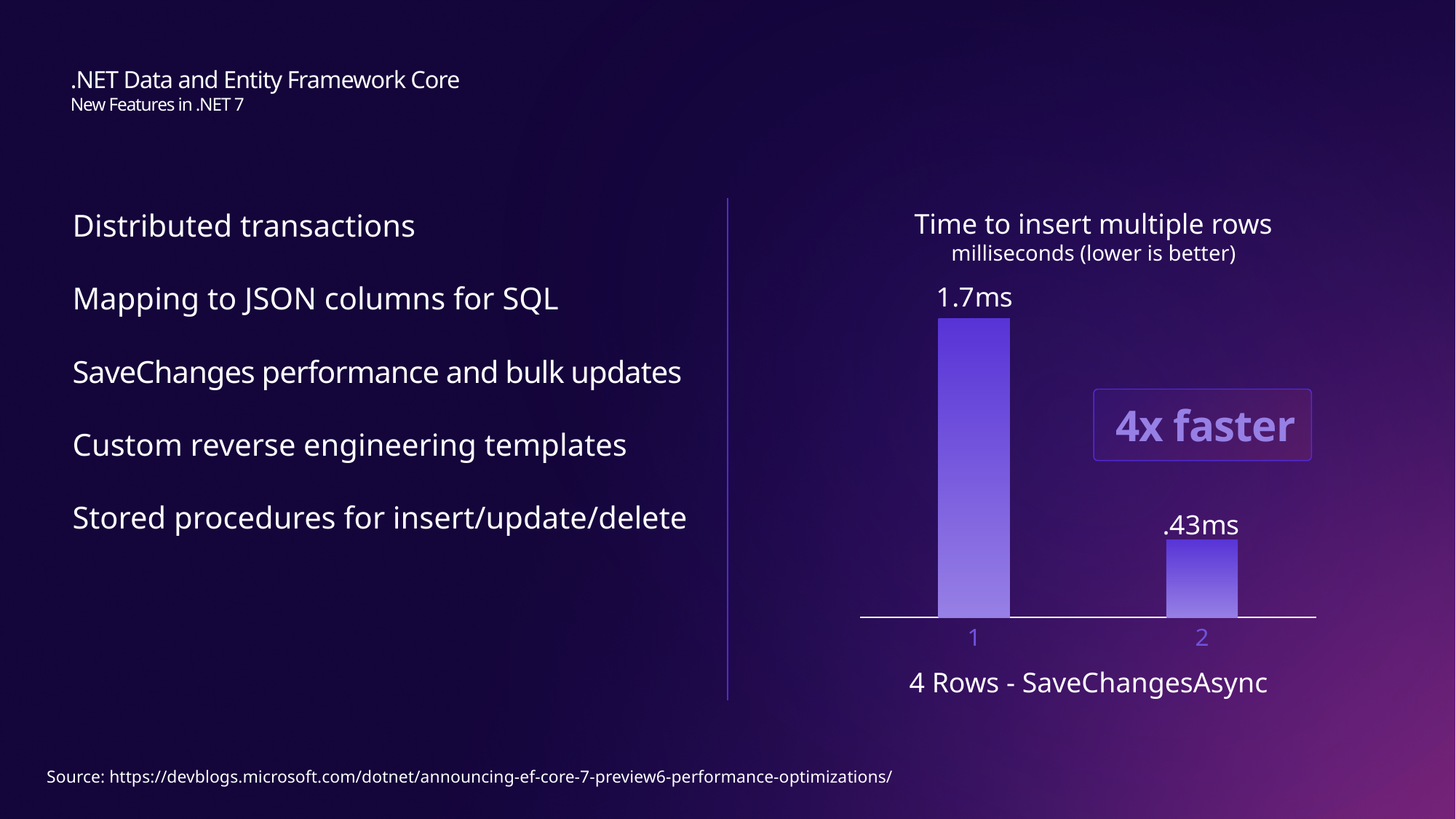
What kind of chart is shown on the slide? Bar chart What is the value for category 2 in the chart? .43ms What is the value for category 1 in the chart? 1.7ms How many bars are plotted in the chart? 2 Which category has the lowest value in the chart? 2 What is the difference between the values for category 1 and category 2? 1.27ms What is the title of the chart? Time to insert multiple rows Do the values rise or fall from category 1 to category 2? Fall Which category has the highest value in the chart? 1 Which is larger, the value for category 1 or category 2? 1 What label appears below the x axis of the chart? 4 Rows - SaveChangesAsync